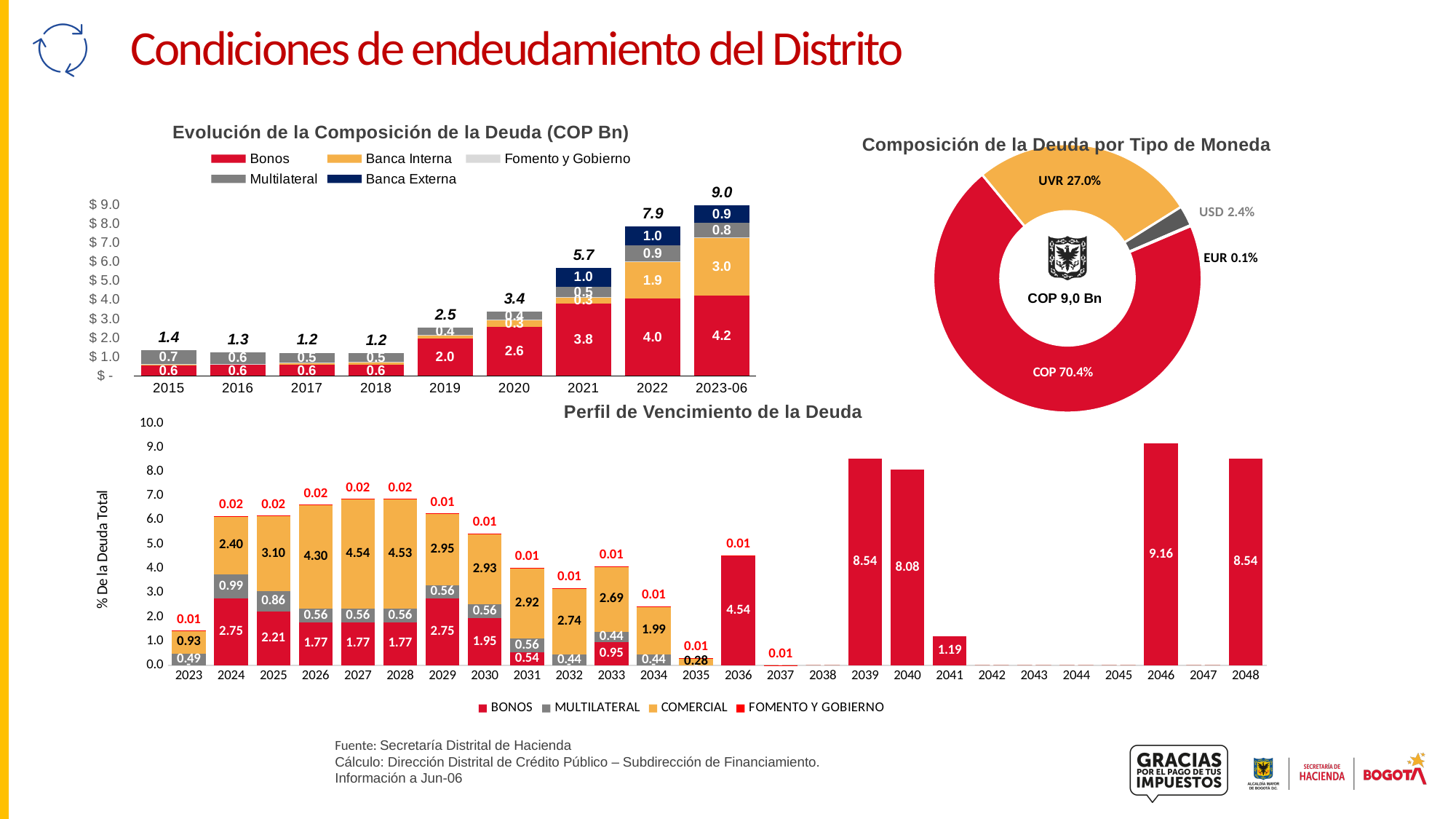
In the 'Evolución de la Composición de la Deuda (COP Bn)' chart, what is the total debt shown for 2023-06? 9.0 In the 'Perfil de Vencimiento de la Deuda' chart, which year has the highest bar? 2046 In the 'Evolución de la Composición de la Deuda (COP Bn)' chart, which year has the lowest total debt? 2017 and 2018 (1.2) In the 'Evolución de la Composición de la Deuda (COP Bn)' chart, what is the Banca Interna value for 2023-06? 3.0 What kind of chart is 'Composición de la Deuda por Tipo de Moneda'? Donut (pie) chart In the 'Perfil de Vencimiento de la Deuda' chart, is the BONOS value for 2039 larger than the BONOS value for 2040? Yes, 2039 (8.54) is larger than 2040 (8.08) In the 'Evolución de la Composición de la Deuda (COP Bn)' chart, what is the Bonos value for 2021? 3.8 In the 'Composición de la Deuda por Tipo de Moneda' chart, what share of the debt is in UVR? 27.0% In the 'Composición de la Deuda por Tipo de Moneda' chart, which currency has the smallest share? EUR In the 'Evolución de la Composición de la Deuda (COP Bn)' chart, how many series does the legend list? 5 In the 'Perfil de Vencimiento de la Deuda' chart, what is the BONOS value for 2046? 9.16 In the 'Evolución de la Composición de la Deuda (COP Bn)' chart, what is the difference between the total for 2022 and the total for 2021? 2.2